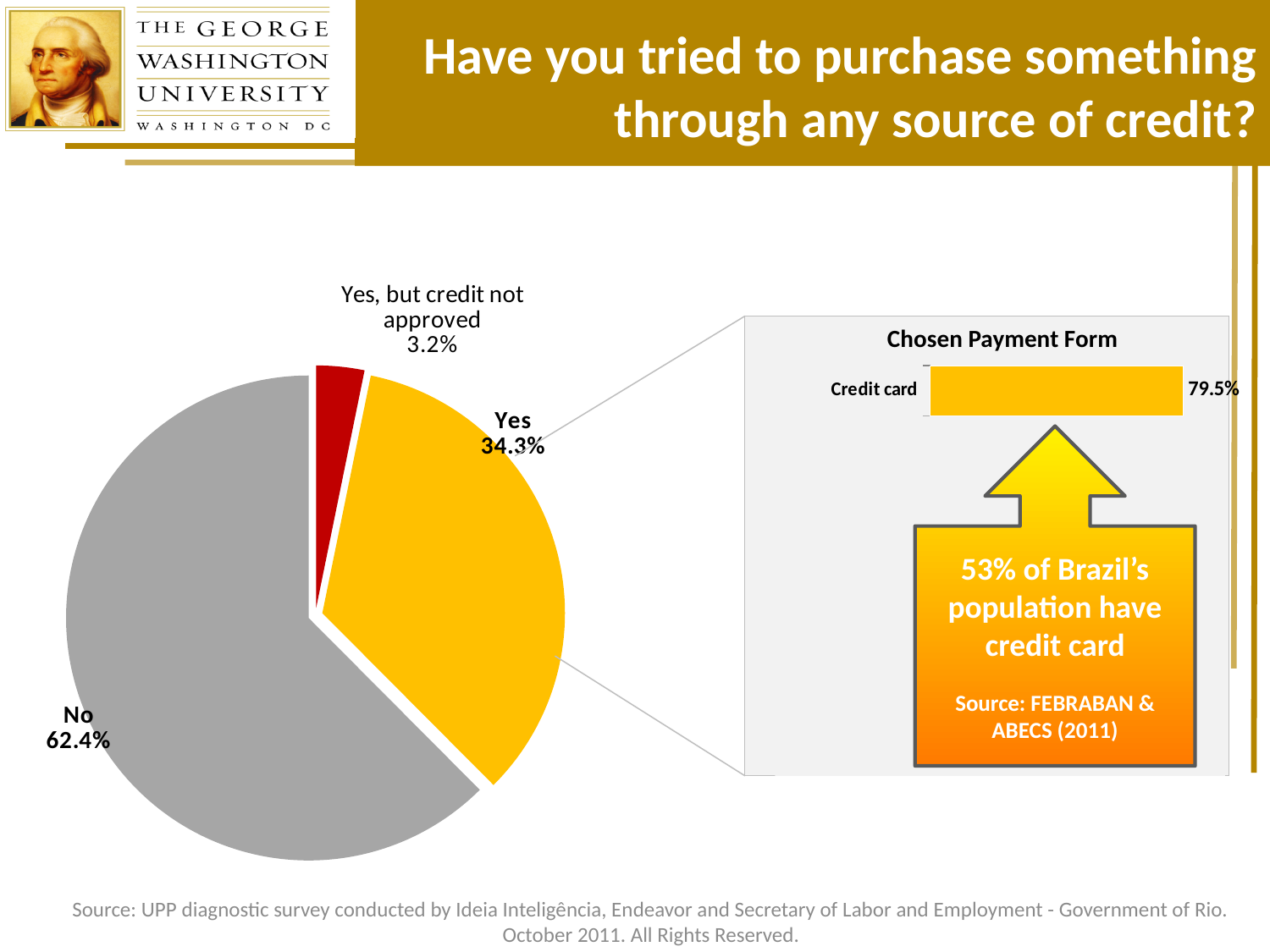
In the pie chart, what is the difference between the "No" share and the "Yes" share? 28.1% In the pie chart, which category has the largest slice? No What kind of chart is the chart on the left of the slide? Pie chart How many categories does the pie chart show? 3 What kind of chart is the "Chosen Payment Form" chart? Bar chart In the "Chosen Payment Form" chart, what is the value for Credit card? 79.5% In the pie chart, which category has the smallest slice? Yes, but credit not approved In the pie chart, what share of respondents answered "Yes, but credit not approved"? 3.2% In the pie chart, what share of respondents answered "No"? 62.4% In the pie chart, what colour is the "No" slice? Grey In the pie chart, what share of respondents answered "Yes"? 34.3% In the pie chart, which is larger: the "Yes" slice or the "No" slice? No